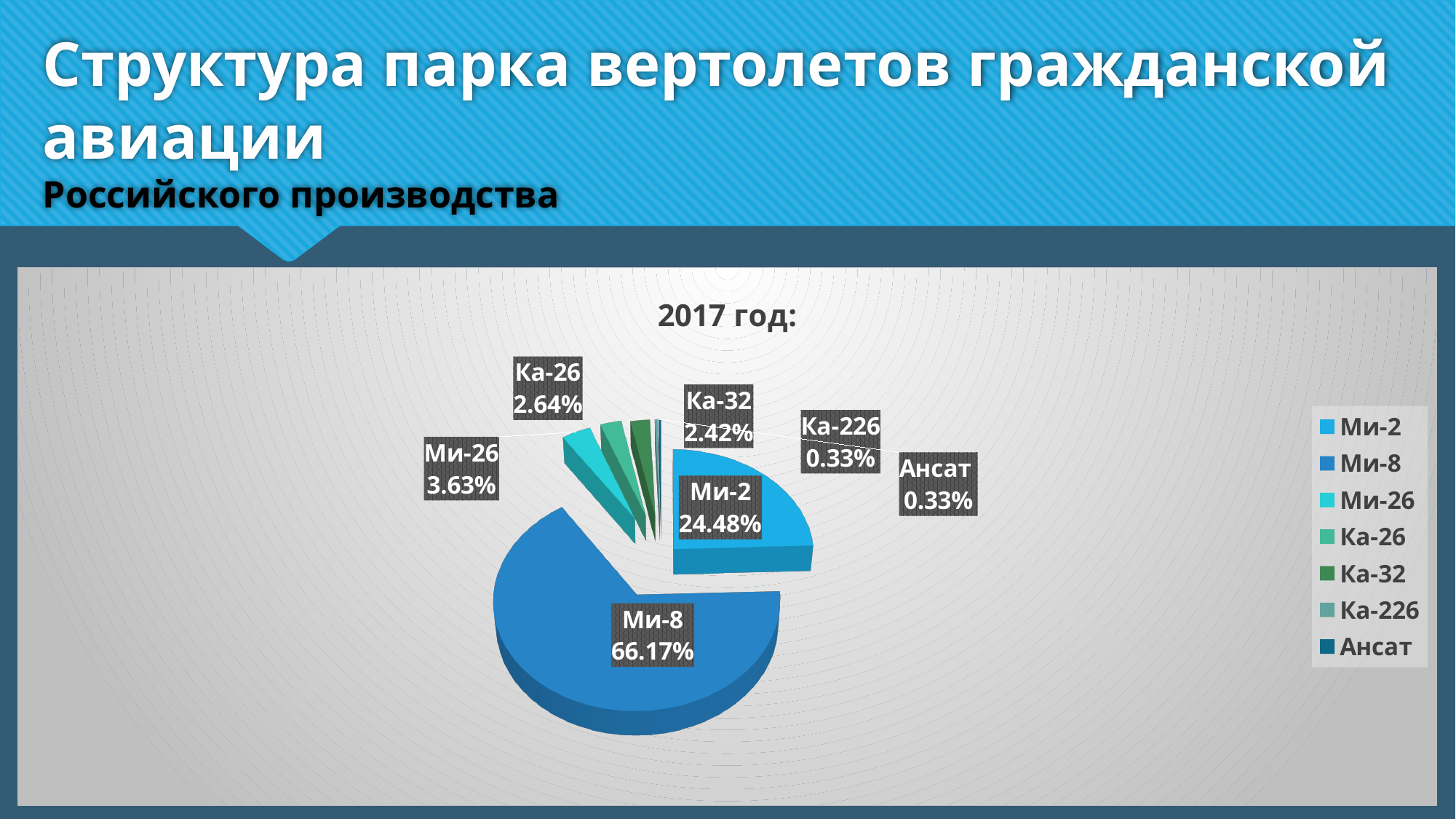
What is the difference between the shares of Ми-8 and Ми-2? 41.69% What share of the pie does Ми-8 hold? 66.17% What is the value shown for Ка-32? 2.42% What is the difference between the shares of Ми-26 and Ка-26? 0.99% Which helicopter type has the largest slice of the pie? Ми-8 What is the value shown for Ми-2? 24.48% How many categories does the legend list? 7 What kind of chart is shown on the slide? Pie chart What share is shown for Ка-226? 0.33% Which helicopter type has the smallest share, Ми-26 or Ка-26? Ка-26 What is the value shown for Ми-26? 3.63% What is the title shown above the pie chart? 2017 год: